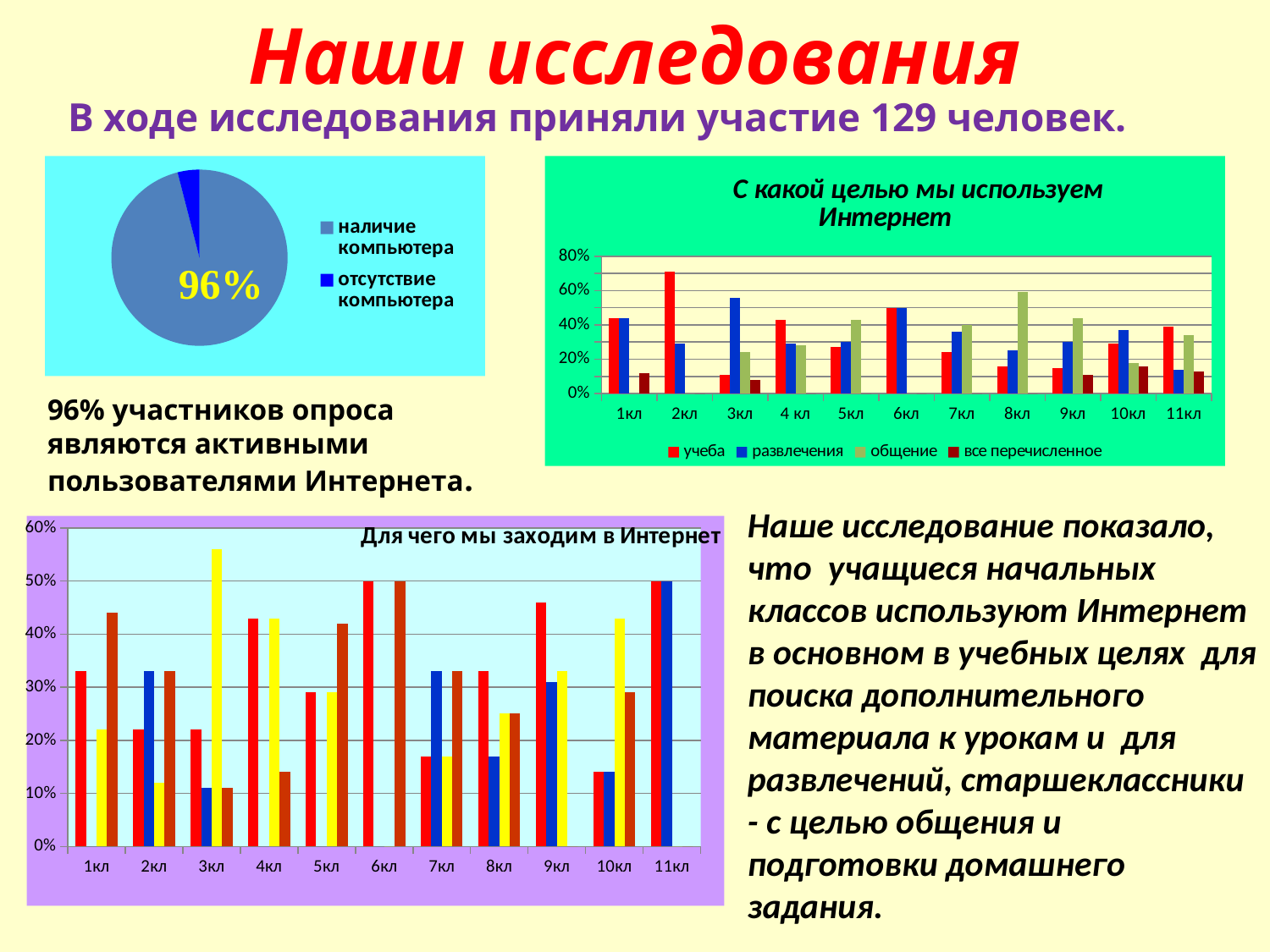
In the chart 'С какой целью мы используем Интернет', is the value for 'учеба' in 2кл greater or less than 60%? greater How many series does the legend of the chart 'С какой целью мы используем Интернет' list? 4 How many class categories are shown on the x axis of the chart 'Для чего мы заходим в Интернет'? 11 How many class categories are shown on the x axis of the chart 'С какой целью мы используем Интернет'? 11 What kind of chart is 'С какой целью мы используем Интернет'? bar chart In the chart 'С какой целью мы используем Интернет', is the value for 'общение' in 8кл greater or less than 40%? greater In the chart 'С какой целью мы используем Интернет', which class has the highest value for 'учеба'? 2кл What kind of chart is 'Для чего мы заходим в Интернет'? bar chart What kind of chart is the top-left chart with the legend 'наличие компьютера' and 'отсутствие компьютера'? pie chart How many slices does the top-left pie chart have? 2 In the top-left pie chart, what share is shown for the larger slice? 96% In the chart 'С какой целью мы используем Интернет', which is larger for 3кл: 'учеба' or 'развлечения'? развлечения